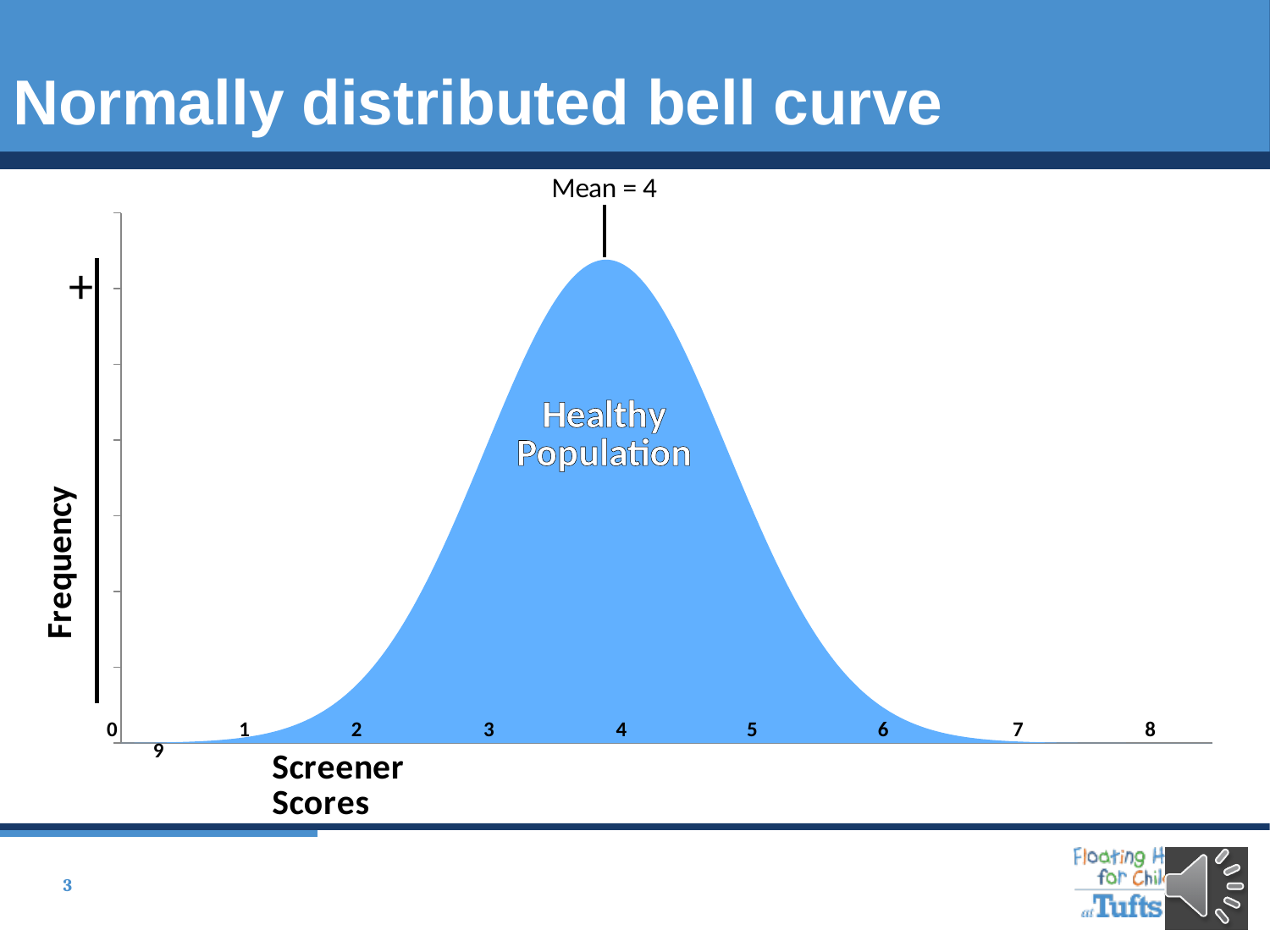
At which screener score does the curve reach its highest frequency? 4 Do the values rise or fall as the screener score goes from 4 to 8? fall How many screener score labels are shown along the x axis? 10 Which has the higher frequency, screener score 3 or screener score 1? 3 What label is printed inside the shaded area of the curve? Healthy Population What is the mean value labelled at the peak of the bell curve? Mean = 4 Is the frequency at screener score 4 larger or smaller than the frequency at screener score 7? larger Do the values rise or fall as the screener score goes from 0 to 4? rise What kind of chart is shown on the slide? Area chart (bell curve) What is the label of the x axis? Screener Scores